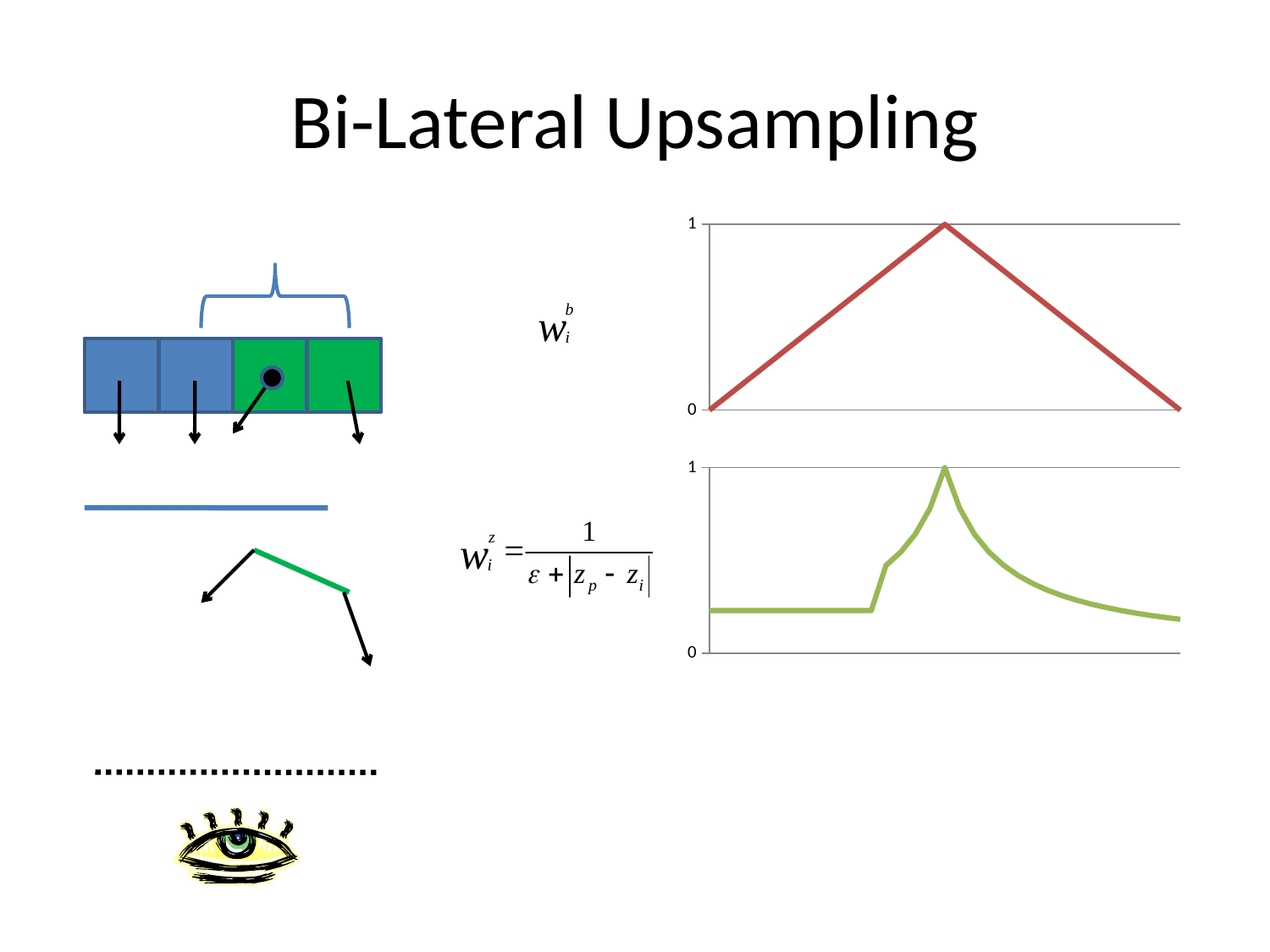
How many charts are shown on the slide? 2 What colour is the line in the bottom chart? green In the bottom chart, what is the peak value of the line? 1 In the top chart, does the line rise or fall along the second half of the x axis? fall In the top chart, what is the highest value the line reaches? 1 In the top chart, what is the lowest value the line reaches? 0 What colour is the line in the top chart? red What kind of chart is the top chart on the right side of the slide? line chart In the top chart, does the line rise or fall along the first half of the x axis? rise In the bottom chart, is the value at the right end of the line greater or less than 0? greater In the bottom chart, is the value at the left end of the line greater or less than 1? less What kind of chart is the bottom chart on the right side of the slide? line chart